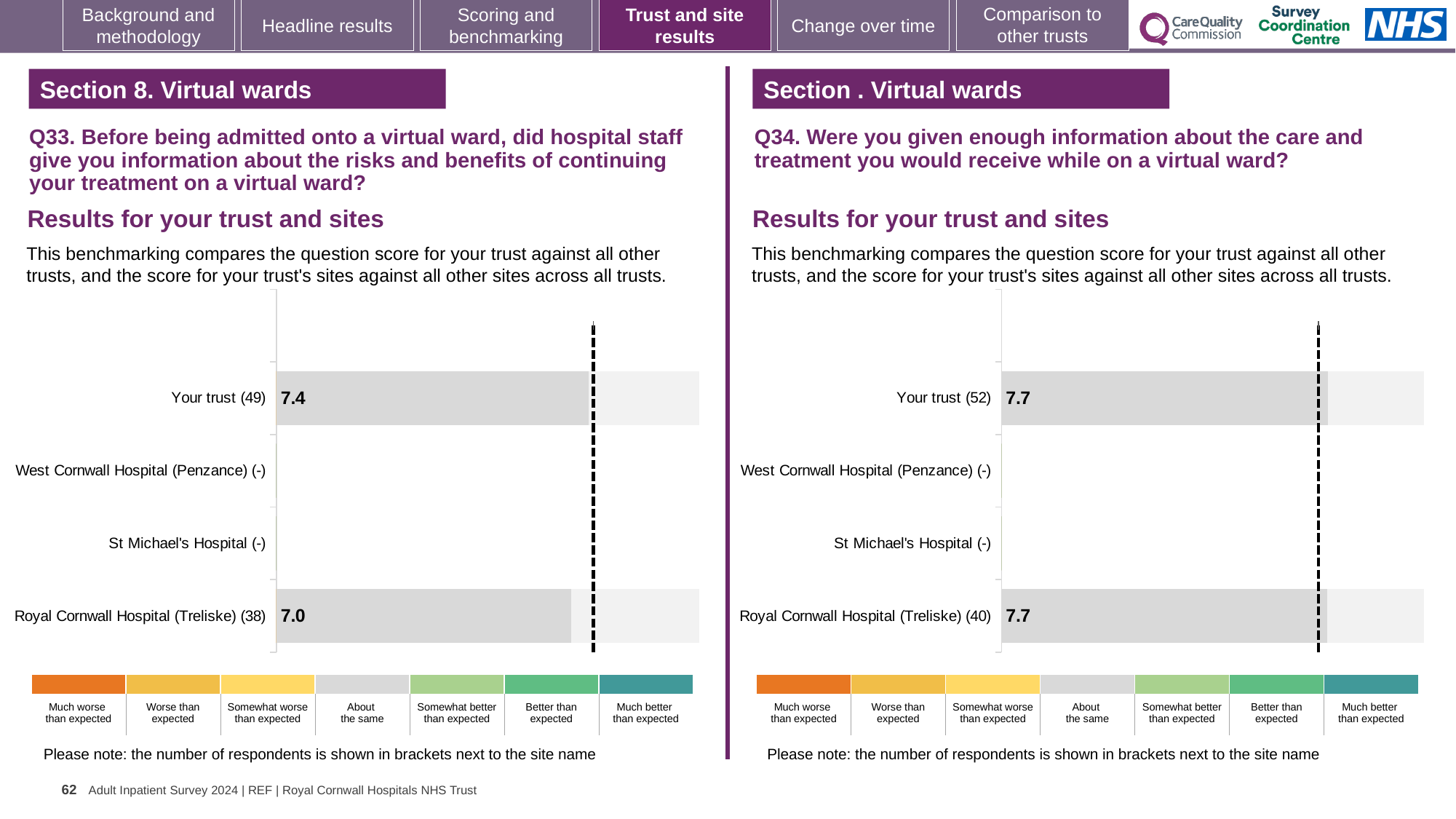
In the Q33 chart on the left, which has the higher score, Your trust or Royal Cornwall Hospital (Treliske)? Your trust In the Q34 chart on the right, what is the score for Your trust? 7.7 What type of chart is used for the Q34 results on the right? Bar chart In the Q34 chart on the right, what is the score for Royal Cornwall Hospital (Treliske)? 7.7 In the Q33 chart on the left, what is the score for Royal Cornwall Hospital (Treliske)? 7.0 In the Q33 chart on the left, how many respondents are shown in brackets for Royal Cornwall Hospital (Treliske)? 38 In the Q33 chart on the left, how many site/trust categories are listed on the vertical axis? 4 In the Q33 chart on the left, what is the difference between the score for Your trust and the score for Royal Cornwall Hospital (Treliske)? 0.4 How many benchmark categories are shown in the colour key below the Q33 chart on the left? 7 In the Q34 chart on the right, how many respondents are shown in brackets for Your trust? 52 In the Q33 chart on the left, what is the score for Your trust? 7.4 In the Q34 chart on the right, how many categories have a score bar plotted? 2